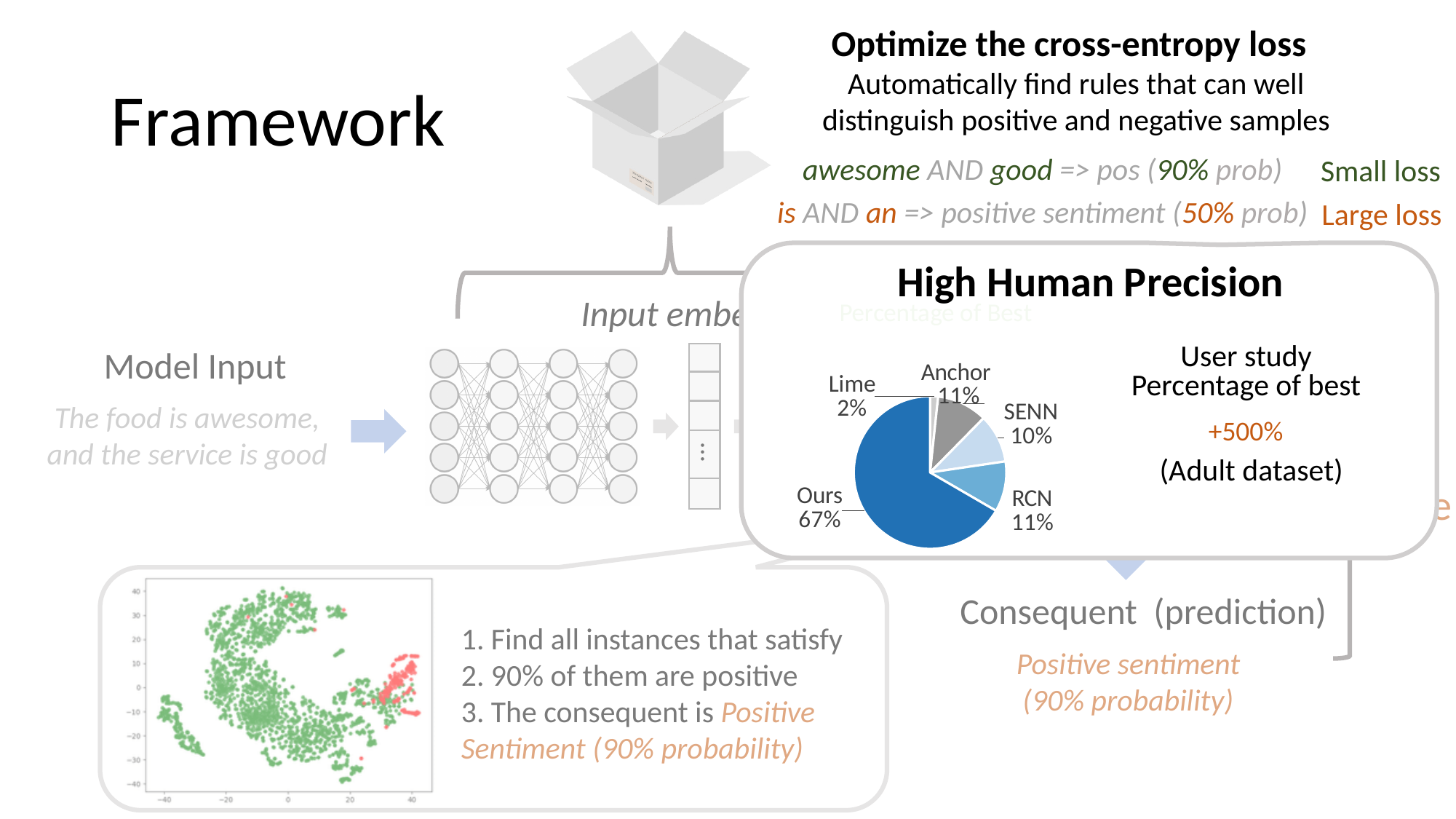
Which method has the smallest slice in the pie chart? Lime What kind of chart is shown in the bottom-left box of the slide? Scatter plot Which method has the largest slice in the pie chart? Ours In the pie chart, what percentage is shown for Ours? 67% In the pie chart, what percentage is shown for RCN? 11% What kind of chart is shown in the 'High Human Precision' box? Pie chart In the pie chart, what percentage is shown for Lime? 2% In the pie chart, what percentage is shown for SENN? 10% In the pie chart, how many percentage points larger is Ours than RCN? 56 percentage points How many slices does the pie chart have? 5 In the pie chart, which is larger, the value for SENN or the value for RCN? RCN In the pie chart, what percentage is shown for Anchor? 11%